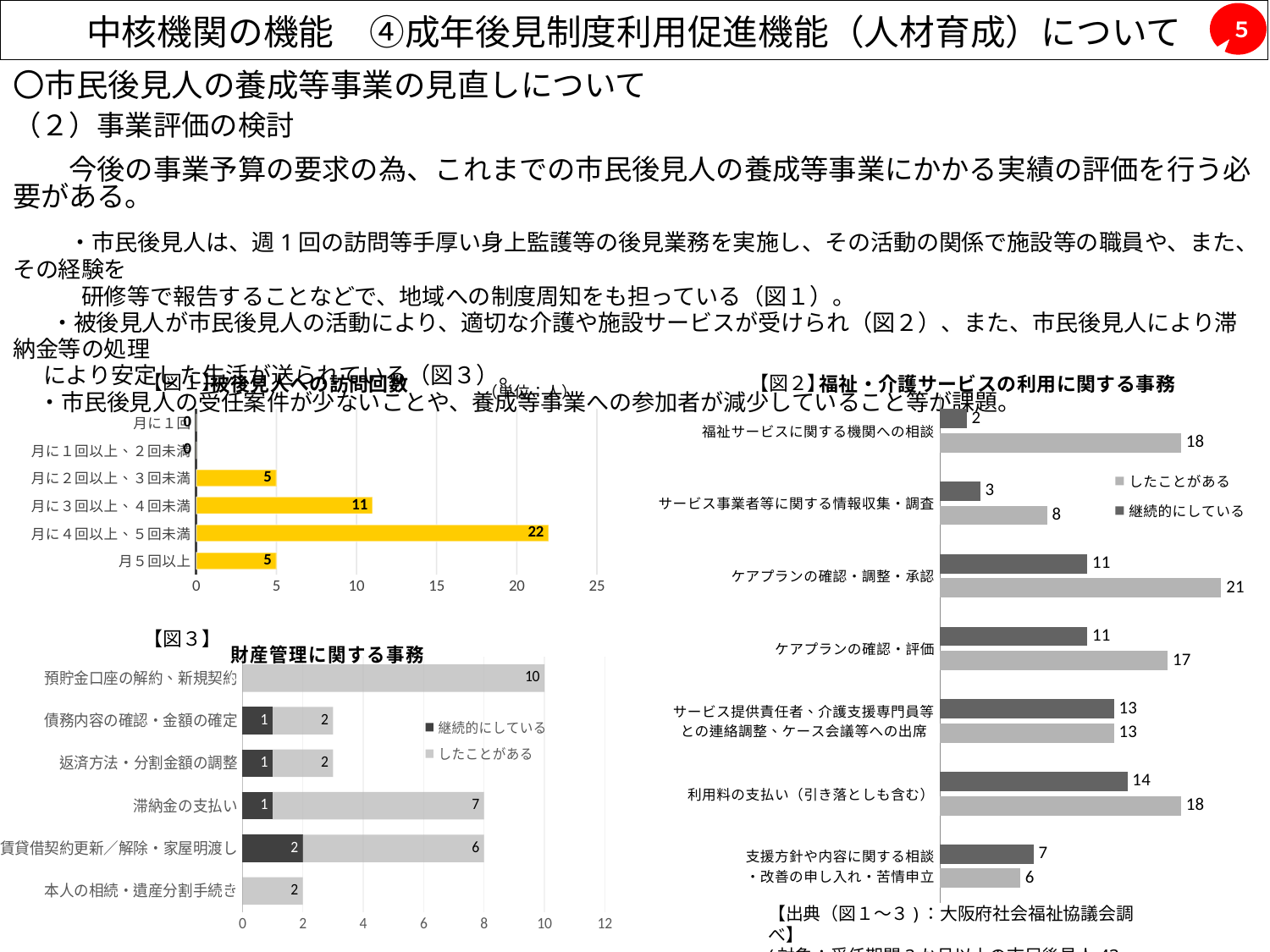
In the chart titled 【図１】被後見人への訪問回数, how many categories are shown on the vertical axis? 6 What kind of chart is 【図１】被後見人への訪問回数? Bar chart In the chart titled 【図１】被後見人への訪問回数, which category has the highest value? 月に４回以上、５回未満 In the chart titled 【図２】福祉・介護サービスの利用に関する事務, what is the 継続的にしている value for 利用料の支払い（引き落としも含む）? 14 In the chart titled 財産管理に関する事務 (図３), which category has the highest value? 預貯金口座の解約、新規契約 In the chart titled 財産管理に関する事務 (図３), what is the 継続的にしている value for 賃貸借契約更新／解除・家屋明渡し? 2 In the chart titled 【図１】被後見人への訪問回数, what is the value for 月に４回以上、５回未満? 22 In the chart titled 【図１】被後見人への訪問回数, what is the difference between the values for 月に４回以上、５回未満 and 月に３回以上、４回未満? 11 In the chart titled 【図２】福祉・介護サービスの利用に関する事務, which is larger for 福祉サービスに関する機関への相談: したことがある or 継続的にしている? したことがある In the chart titled 【図２】福祉・介護サービスの利用に関する事務, what is the したことがある value for ケアプランの確認・調整・承認? 21 In the chart titled 財産管理に関する事務 (図３), what is the total of the stacked bar for 滞納金の支払い? 8 How many series does the legend of 【図２】福祉・介護サービスの利用に関する事務 list? 2